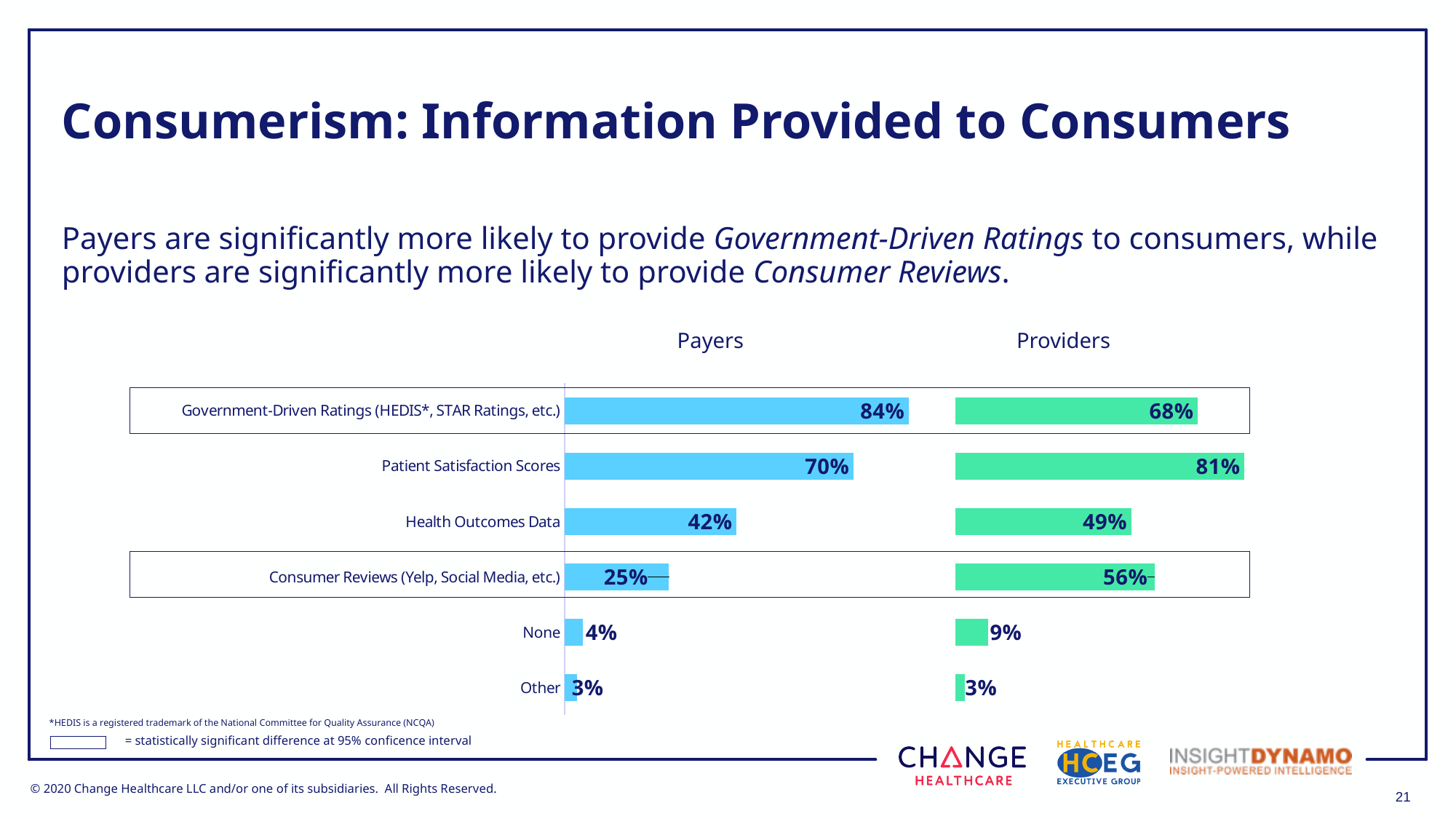
In the Payers chart, which category has the highest value? Government-Driven Ratings (HEDIS*, STAR Ratings, etc.) What kind of chart is used to show the Payers and Providers data? Bar chart In the Providers chart, which category has the lowest value? Other What is the difference between the Providers and Payers values for Consumer Reviews (Yelp, Social Media, etc.)? 31 percentage points How many categories are shown in the Payers chart? 6 For Health Outcomes Data, which is larger: the Payers value or the Providers value? Providers In the Payers chart, what percentage is shown for Health Outcomes Data? 42% In the Providers chart, what percentage is shown for Patient Satisfaction Scores? 81% What is the difference between the Payers and Providers values for Government-Driven Ratings (HEDIS*, STAR Ratings, etc.)? 16 percentage points In the Providers chart, which category has the highest value? Patient Satisfaction Scores In the Payers chart, what percentage is shown for Government-Driven Ratings (HEDIS*, STAR Ratings, etc.)? 84% In the Providers chart, what percentage is shown for Consumer Reviews (Yelp, Social Media, etc.)? 56%